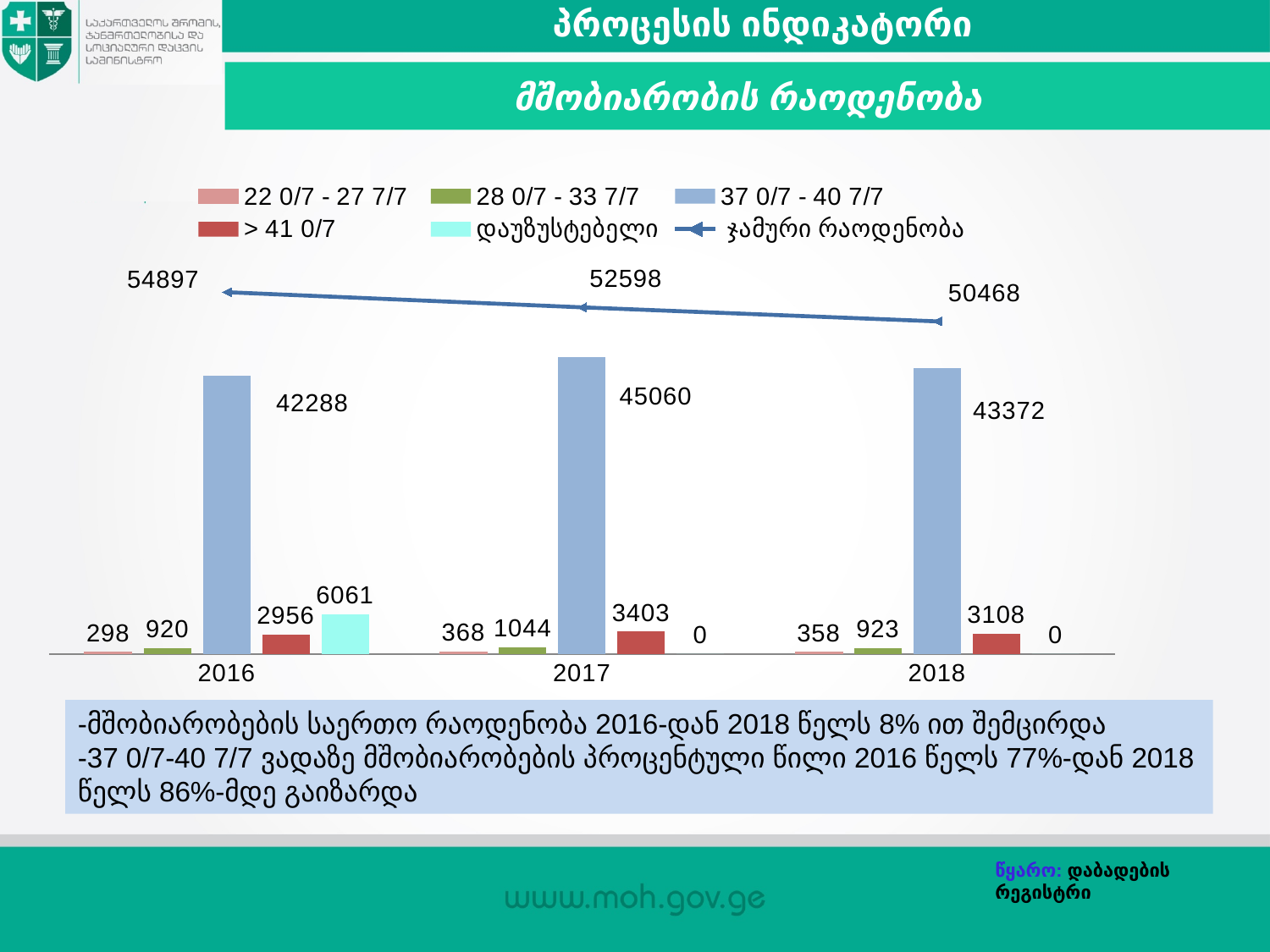
How many entries does the legend list? 6 What is the value for the "> 41 0/7" series in 2016? 2956 Which is larger: the "> 41 0/7" value in 2017 or in 2018? 2017 What is the value for the "37 0/7 - 40 7/7" series in 2017? 45060 How many years are shown on the x axis? 3 What kind of chart is this? Bar chart with a line What is the total (ჯამური რაოდენობა) shown for 2018? 50468 What is the value for the "დაუზუსტებელი" series in 2016? 6061 In which year is the total (ჯამური რაოდენობა) lowest? 2018 What is the difference between the total for 2016 and the total for 2018? 4429 In which year is the "37 0/7 - 40 7/7" value highest? 2017 Does the total (ჯამური რაოდენობა) line rise or fall from 2016 to 2018? Fall